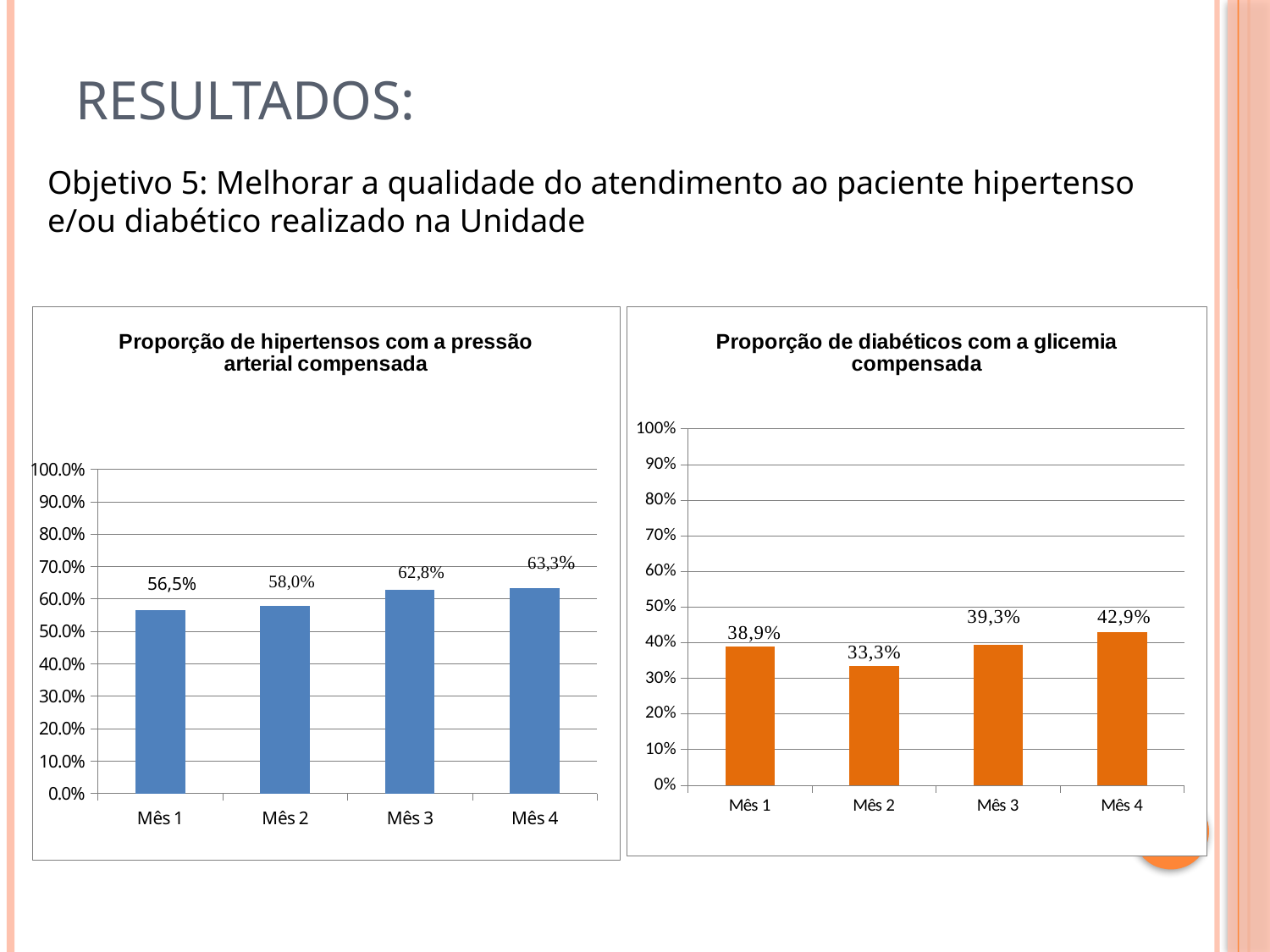
In the chart 'Proporção de hipertensos com a pressão arterial compensada', what is the value for Mês 3? 62,8% In the chart 'Proporção de hipertensos com a pressão arterial compensada', what is the value for Mês 1? 56,5% In the chart 'Proporção de diabéticos com a glicemia compensada', which month has the lowest value? Mês 2 In the chart 'Proporção de diabéticos com a glicemia compensada', which is larger, the value for Mês 1 or Mês 3? Mês 3 What type of chart is 'Proporção de hipertensos com a pressão arterial compensada'? bar chart How many months are shown in the chart 'Proporção de diabéticos com a glicemia compensada'? 4 In the chart 'Proporção de diabéticos com a glicemia compensada', what is the value for Mês 2? 33,3% In the chart 'Proporção de diabéticos com a glicemia compensada', what is the difference between Mês 3 and Mês 2? 6,0% In the chart 'Proporção de hipertensos com a pressão arterial compensada', do the values rise or fall from Mês 1 to Mês 4? rise In the chart 'Proporção de diabéticos com a glicemia compensada', what is the value for Mês 4? 42,9% In the chart 'Proporção de hipertensos com a pressão arterial compensada', what is the difference between Mês 4 and Mês 1? 6,8% In the chart 'Proporção de hipertensos com a pressão arterial compensada', which month has the highest value? Mês 4